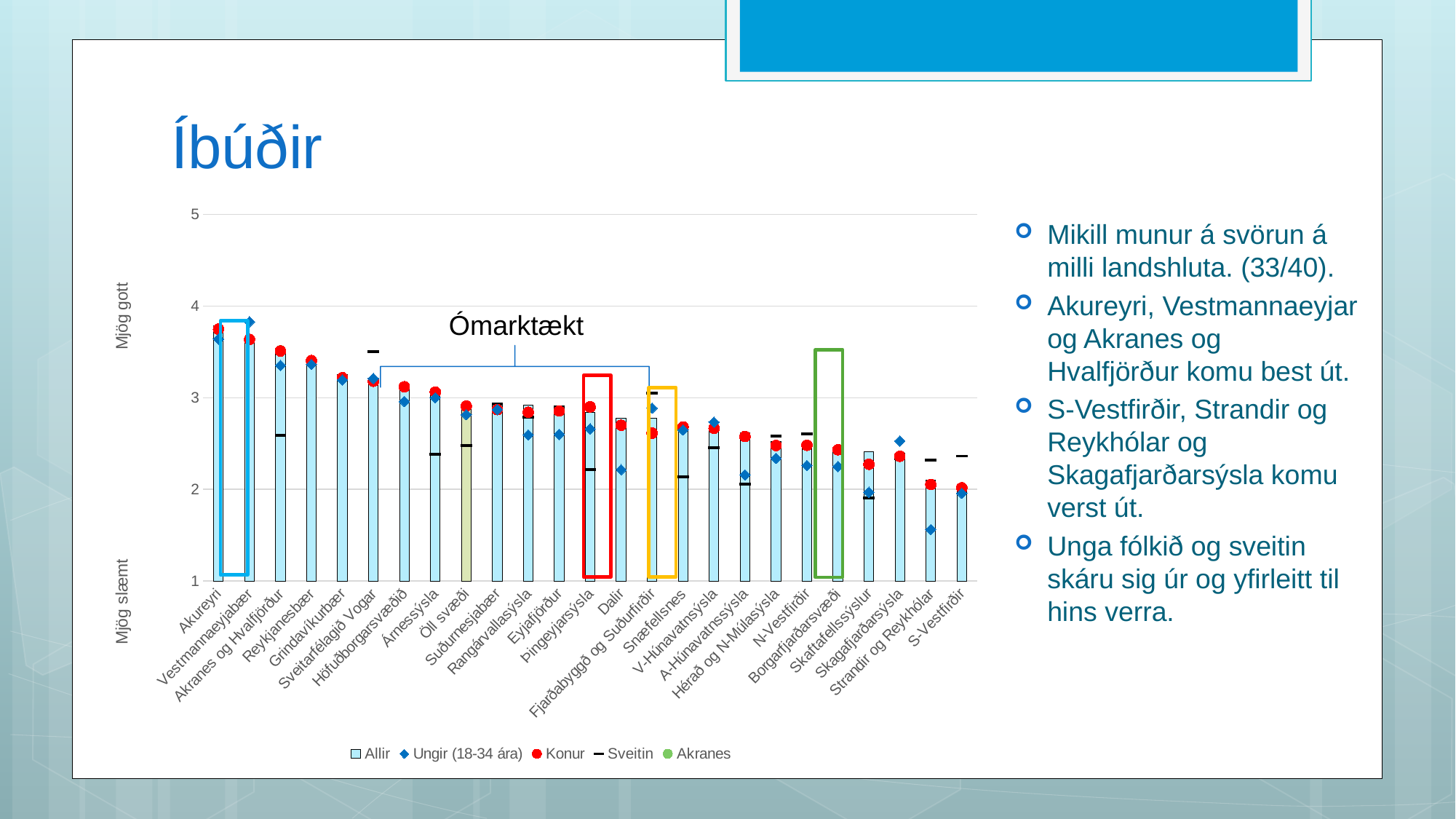
Which region has the highest Allir bar in the chart? Akureyri What is the title of the slide containing the chart? Íbúðir Which has the larger Allir value, Akureyri or S-Vestfirðir? Akureyri How many categories (regions) are shown along the x axis of the chart? 25 Is the Allir value for Akureyri greater or less than 3? greater How many series does the chart legend list? 5 Do the Allir bar values generally rise or fall from left to right along the x axis? fall Is the Allir value for Strandir og Reykhólar greater or less than 3? less Is the Allir value for Reykjanesbær greater or less than 3? greater What label appears at the top of the chart's y axis? Mjög gott What kind of chart is shown on the slide? bar chart